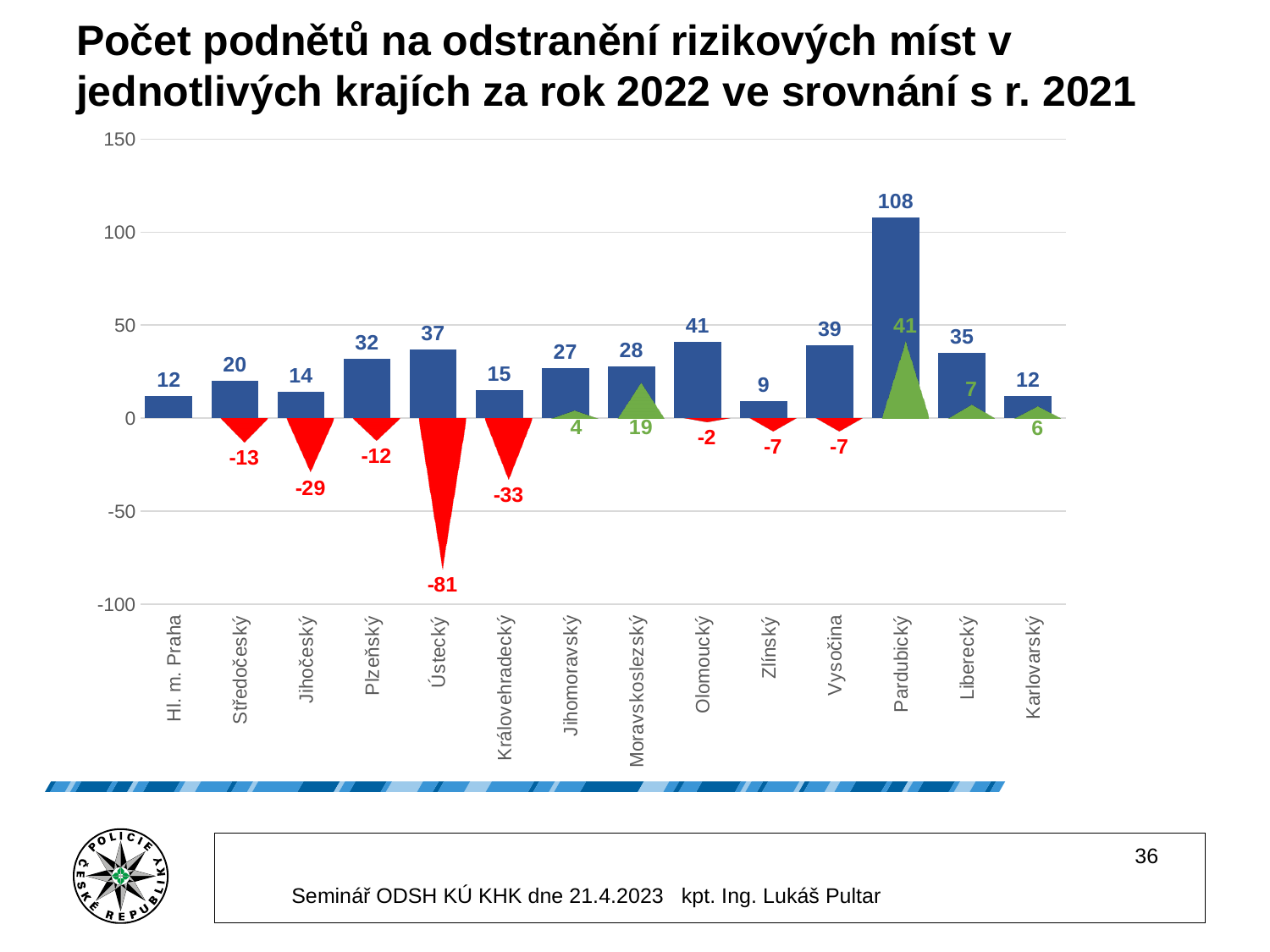
What is the red value shown below the axis for Jihočeský? -29 Which region has the highest blue bar? Pardubický How many regions are shown on the x axis? 14 What is the difference between the blue bar values for Pardubický and Olomoucký? 67 Is the blue bar value for Pardubický greater or less than 100? greater What is the red value shown below the axis for Ústecký? -81 Which region has the lowest blue bar? Zlínský What is the green value shown for Moravskoslezský? 19 What is the value of the blue bar for Pardubický? 108 What is the value of the blue bar for Ústecký? 37 What kind of chart is shown on the slide? bar chart Which has a larger blue bar value, Plzeňský or Liberecký? Liberecký